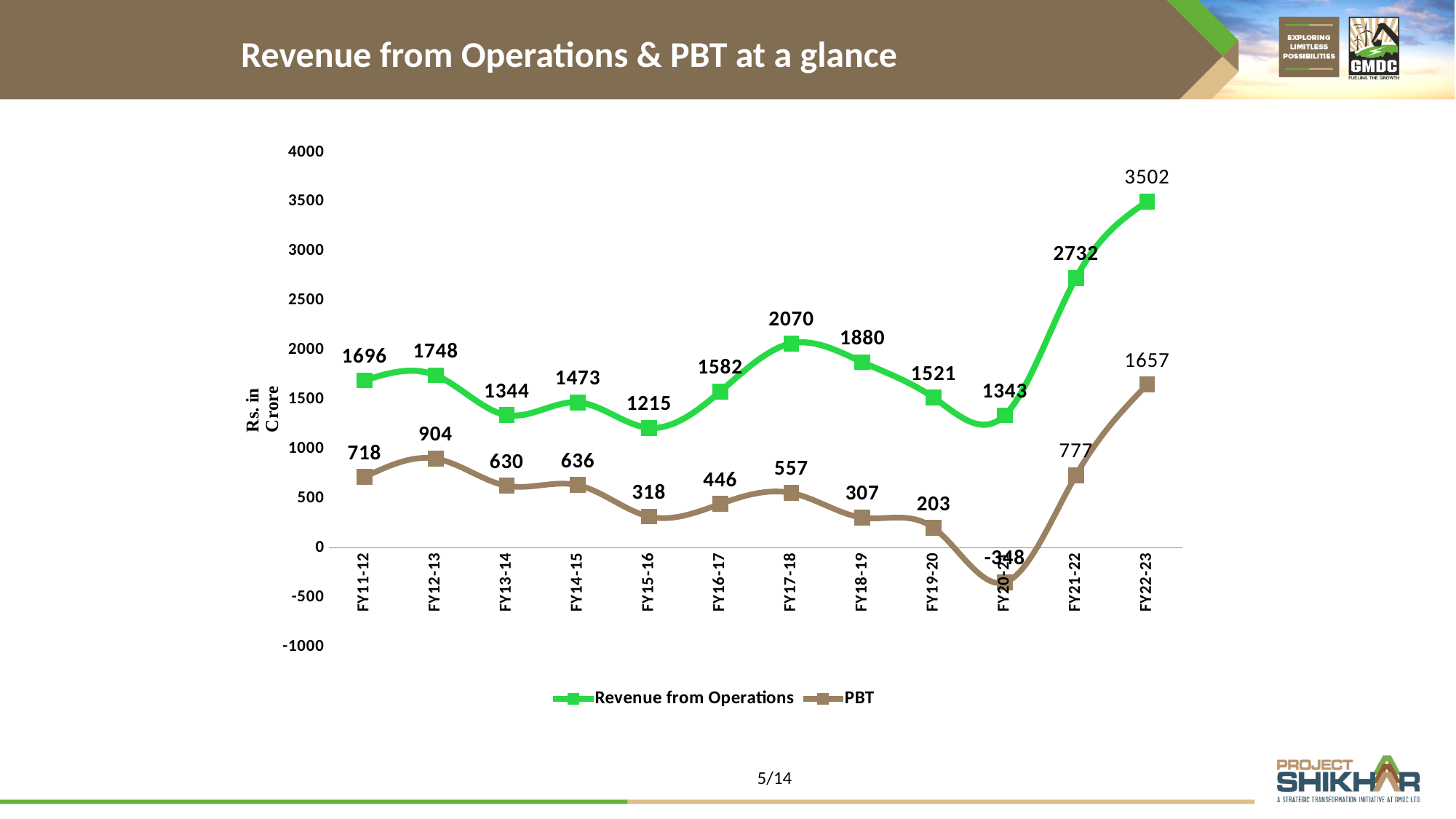
What is the y-axis label of the chart? Rs. in Crore Which fiscal year has the highest Revenue from Operations? FY22-23 How many fiscal years are shown on the x axis? 12 Which is larger, the PBT for FY12-13 or the PBT for FY21-22? FY12-13 How many series does the legend list? 2 What is the difference between Revenue from Operations and PBT in FY22-23? 1845 Which fiscal year has the lowest PBT? FY20-21 Which fiscal year has the lowest Revenue from Operations? FY15-16 What is the PBT for FY20-21? -348 What is the PBT for FY15-16? 318 What kind of chart is shown on the slide? Line chart What is the Revenue from Operations for FY22-23? 3502